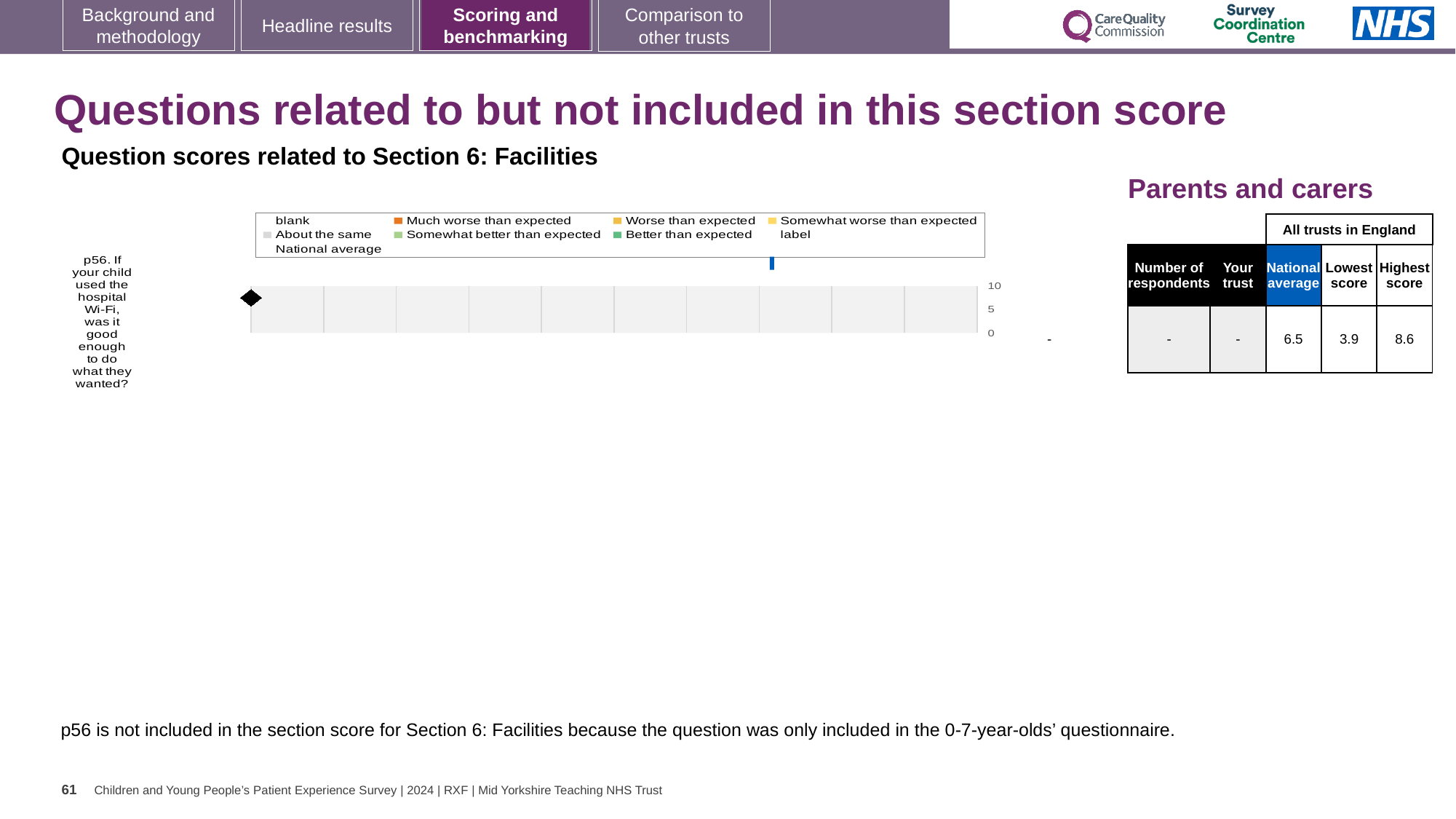
What is the highest tick value shown on the chart's score axis? 10 Which legend entry is shown in orange on the chart? Much worse than expected What kind of chart is shown for the question scores related to Section 6: Facilities? bar chart What value is printed for the trust's score for p56 next to the chart? - How many questions (categories) are plotted on the chart? 1 Which question is plotted on the chart? p56. If your child used the hospital Wi-Fi, was it good enough to do what they wanted?